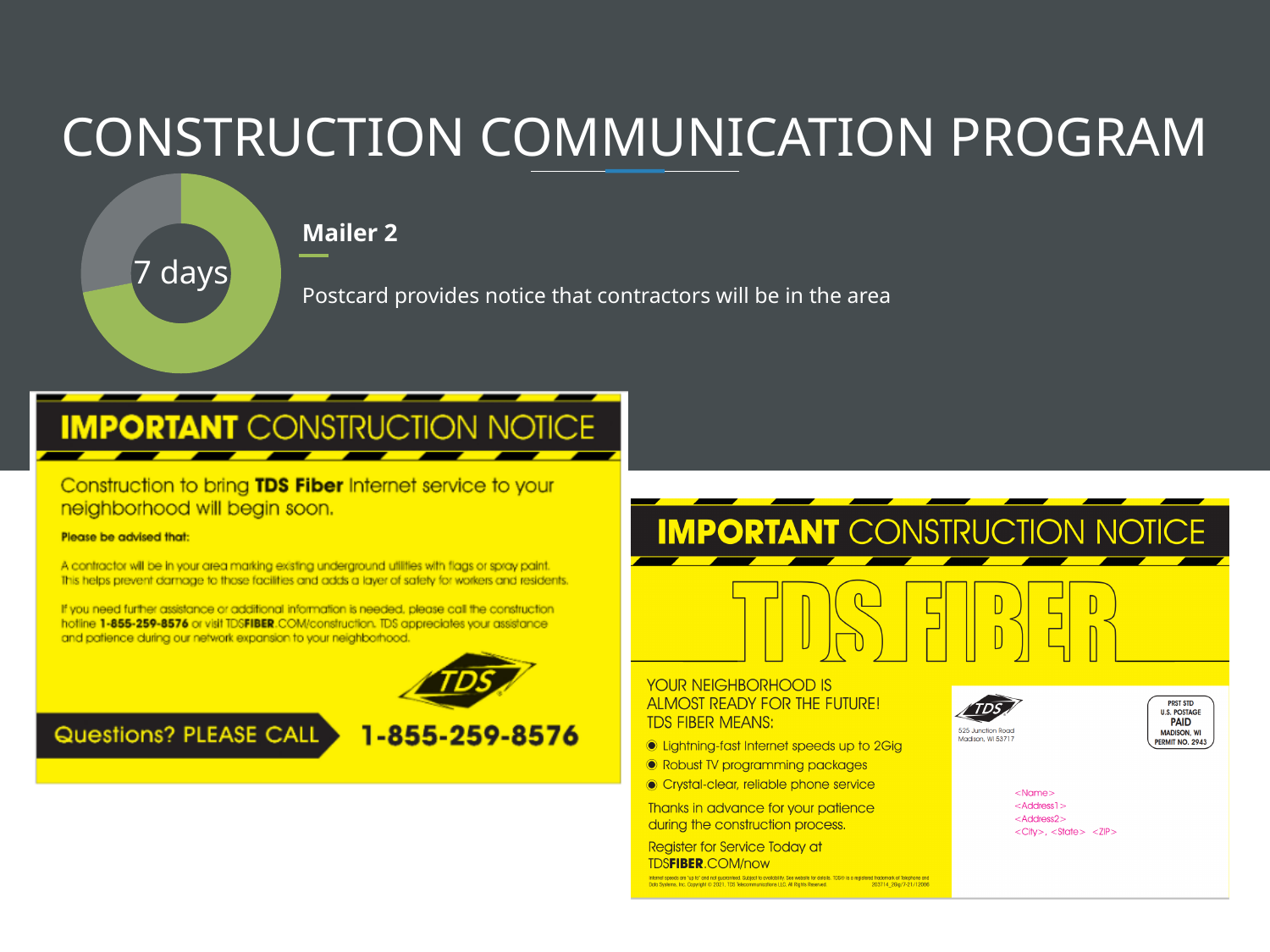
Does the doughnut chart have a legend? No What text is printed in the centre of the doughnut chart? 7 days What kind of chart is shown on the slide? Doughnut chart Which segment of the doughnut chart is larger, the green one or the grey one? The green one How many segments does the doughnut chart have? 2 What two colours are used for the segments of the doughnut chart? Green and grey